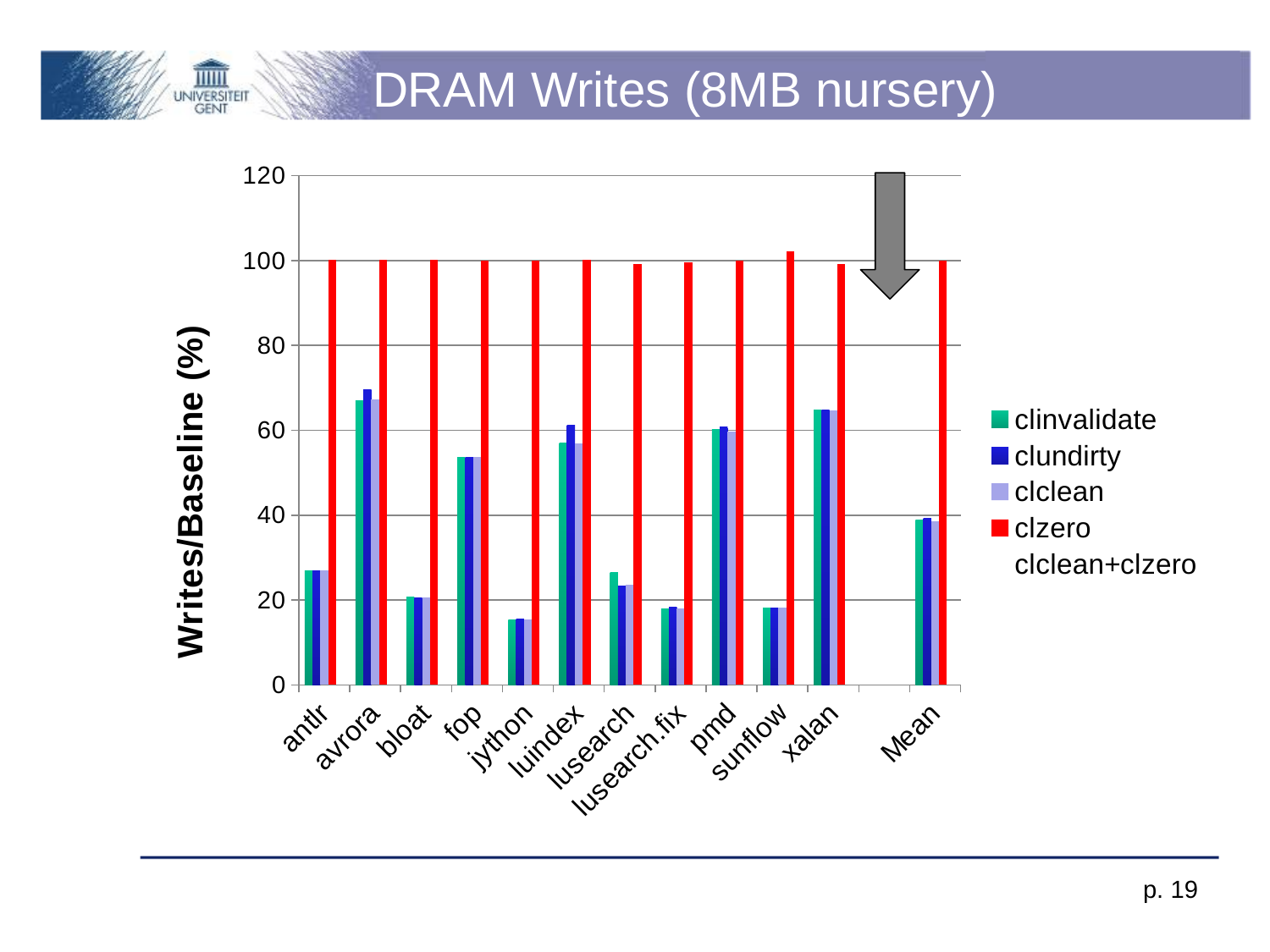
Is the clinvalidate value for avrora greater or less than 60? greater How many entries does the chart's legend list? 5 Is the clinvalidate value for Mean greater or less than 60? less Which has the larger clinvalidate value, avrora or bloat? avrora What kind of chart is shown on the slide? bar chart Is the clundirty value for bloat greater or less than 40? less What is the title of the chart? DRAM Writes (8MB nursery) How many categories are shown along the x axis of the chart? 12 Which has the larger clundirty value, fop or jython? fop What is the label on the vertical axis of the chart? Writes/Baseline (%)